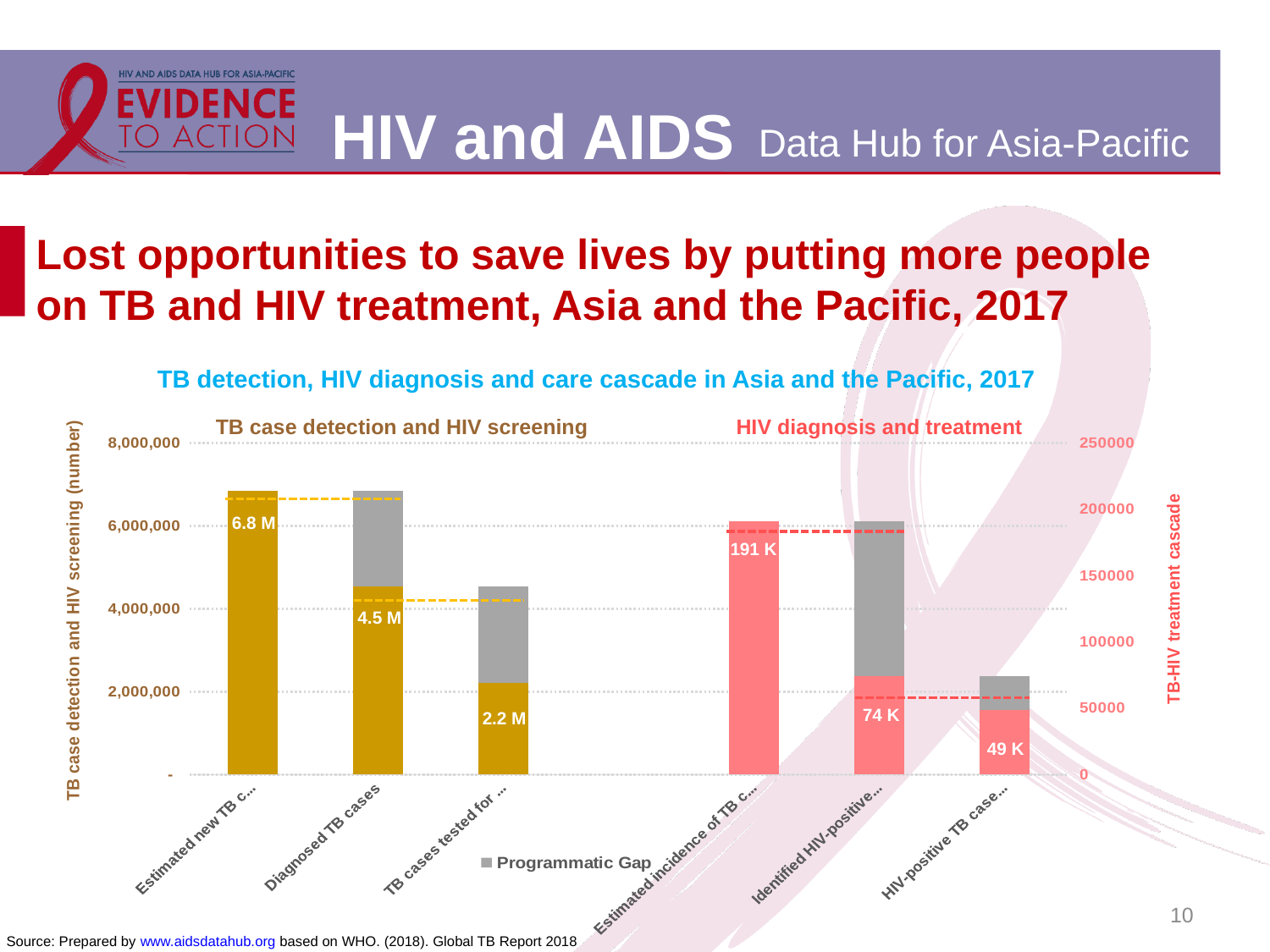
Which bar in the TB case detection and HIV screening group has the lowest labelled value? TB cases tested for ... (2.2 M) What is the chart title shown above the bars? TB detection, HIV diagnosis and care cascade in Asia and the Pacific, 2017 What is the value labelled on the last bar (HIV-positive TB cases) in the HIV diagnosis and treatment group? 49 K What kind of chart is used on this slide? bar chart What is the difference between the labelled values of the Identified HIV-positive bar (74 K) and the HIV-positive TB cases bar (49 K)? 25 K Do the labelled values fall or rise from left to right within the HIV diagnosis and treatment group? fall Which is larger: the labelled value for Diagnosed TB cases or for TB cases tested? Diagnosed TB cases What is the value labelled on the first bar (Estimated new TB cases) in the TB case detection and HIV screening group? 6.8 M How many bars are plotted in total across both groups? 6 What is the difference between the labelled values of the Estimated new TB cases bar (6.8 M) and the Diagnosed TB cases bar (4.5 M)? 2.3 M What is the value labelled on the Diagnosed TB cases bar? 4.5 M What is the value labelled on the first bar (Estimated incidence of TB) in the HIV diagnosis and treatment group? 191 K